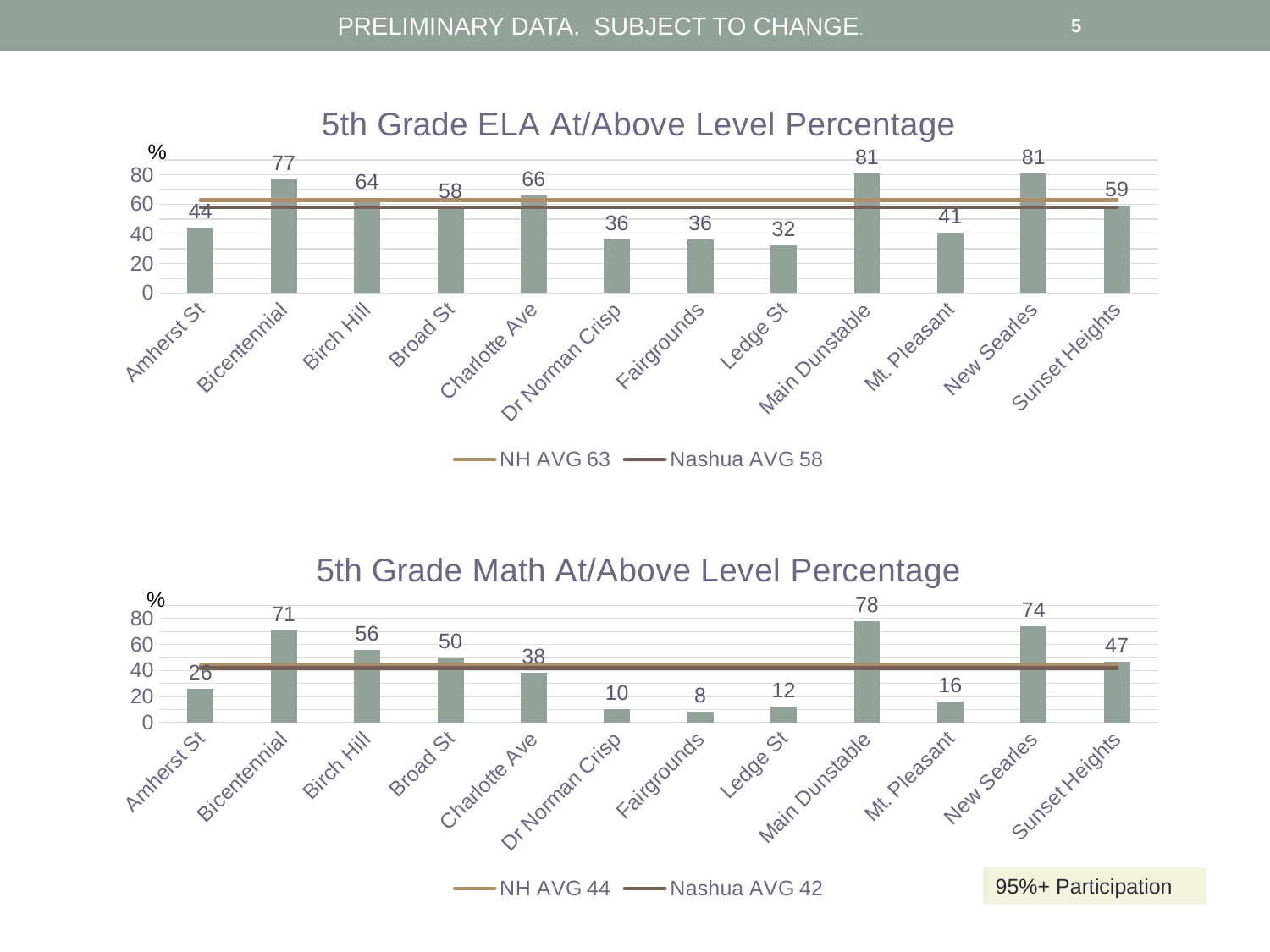
In the 5th Grade Math At/Above Level Percentage chart, what is the value for Charlotte Ave? 38 In the 5th Grade Math At/Above Level Percentage chart, which school has the highest value? Main Dunstable In the 5th Grade Math At/Above Level Percentage chart, which school has the lowest value? Fairgrounds In the 5th Grade Math At/Above Level Percentage chart, is the value for Sunset Heights greater or less than 40? greater In the 5th Grade ELA At/Above Level Percentage chart, what is the value for Bicentennial? 77 In the 5th Grade ELA At/Above Level Percentage chart, what NH average value does the legend show? 63 In the 5th Grade ELA At/Above Level Percentage chart, what is the difference between Main Dunstable and Amherst St? 37 In the 5th Grade ELA At/Above Level Percentage chart, which school has the lowest value? Ledge St How many schools are shown on the x axis of the 5th Grade ELA At/Above Level Percentage chart? 12 In the 5th Grade Math At/Above Level Percentage chart, what is the difference between New Searles and Mt. Pleasant? 58 In the 5th Grade ELA At/Above Level Percentage chart, which is larger, Birch Hill or Broad St? Birch Hill What kind of chart is the 5th Grade Math At/Above Level Percentage chart? bar chart